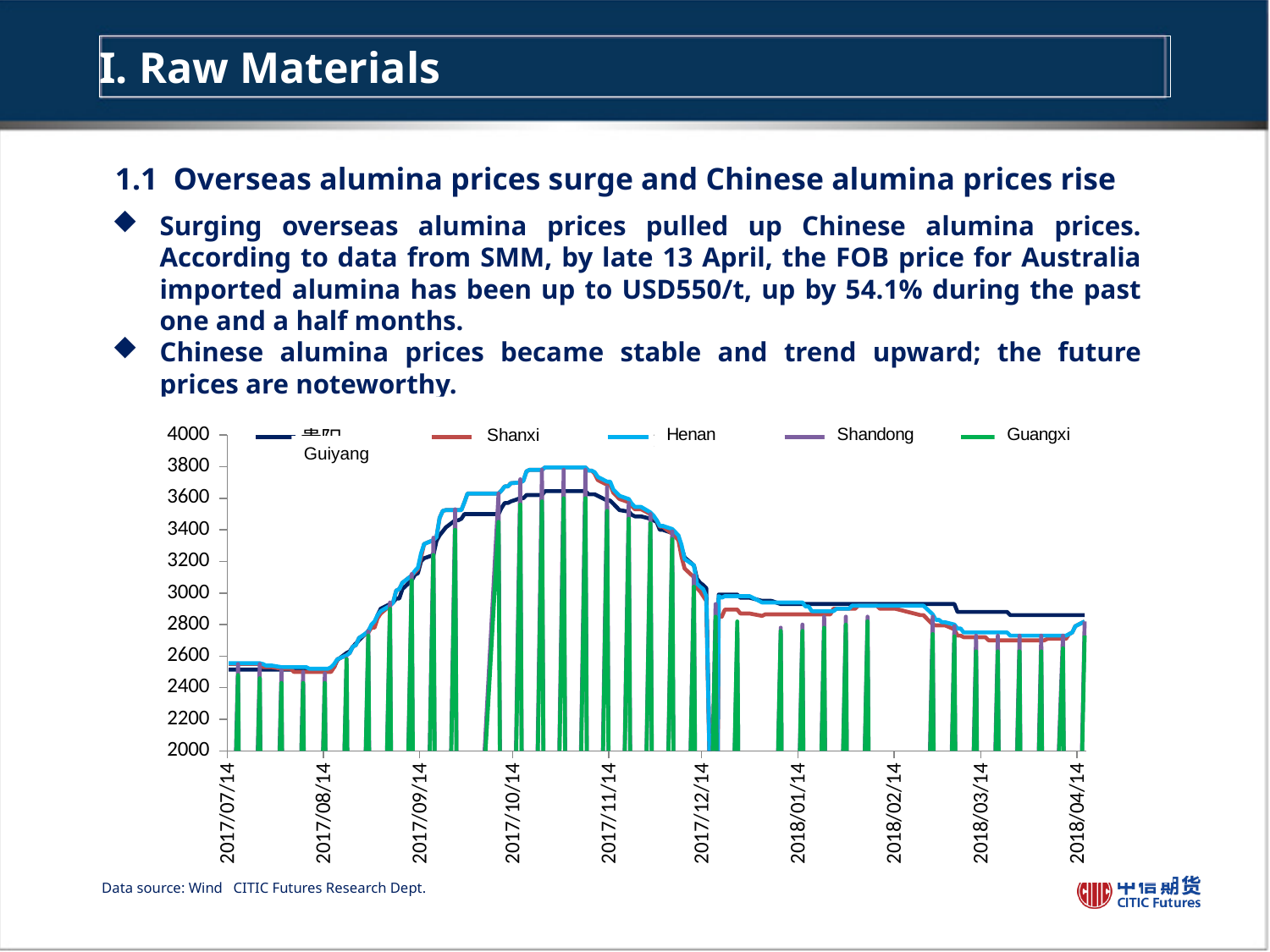
What is the lowest value shown on the chart's vertical axis? 2000 Is the value for Shanxi at 2018/03/14 greater or less than 2800? less What kind of chart is shown on the slide? line chart Is the value for Guiyang at 2018/04/14 greater or less than 3000? less Is the value for Guiyang at 2017/07/14 greater or less than 2400? greater How many date labels are shown along the x axis of the chart? 10 Which series is drawn in green in the chart? Guangxi Does the Henan series rise or fall between 2017/08/14 and 2017/10/14? rise At 2018/03/14, which is higher, Guiyang or Shanxi? Guiyang How many series does the chart legend list? 5 At 2017/10/14, which is higher, Henan or Guiyang? Henan